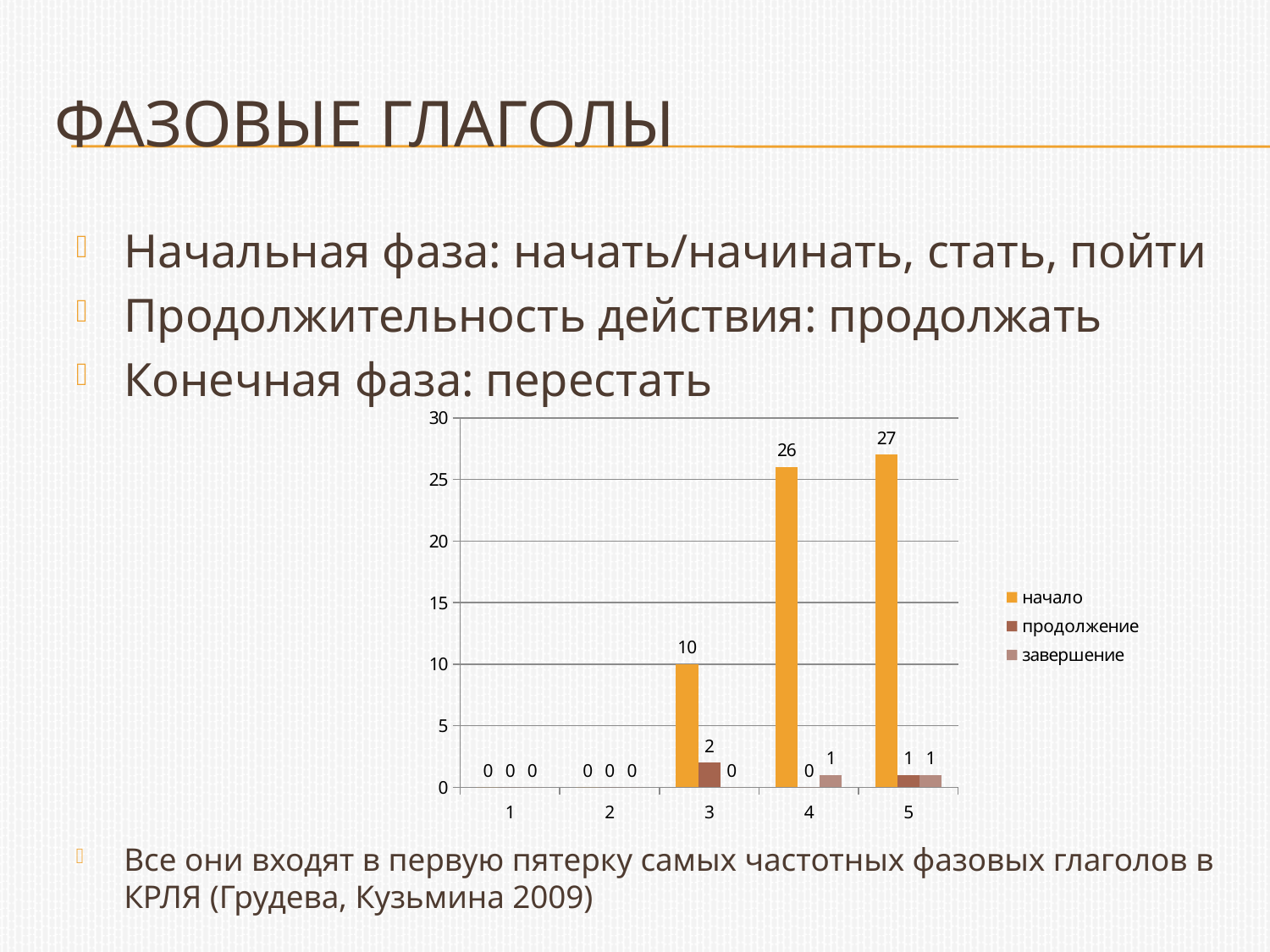
What is the value of the начало series for category 4? 26 What is the value of the завершение series for category 4? 1 How many categories are shown on the x axis? 5 What is the value of the продолжение series for category 3? 2 What is the value of the начало series for category 5? 27 Which category has the highest value for the начало series? 5 How many series does the legend list? 3 Which is larger: the начало value for category 3 or for category 4? category 4 What kind of chart is shown on the slide? bar chart Is the начало value for category 4 greater or less than 20? greater Which series is shown in orange in the legend? начало What is the difference between the начало values for category 5 and category 3? 17